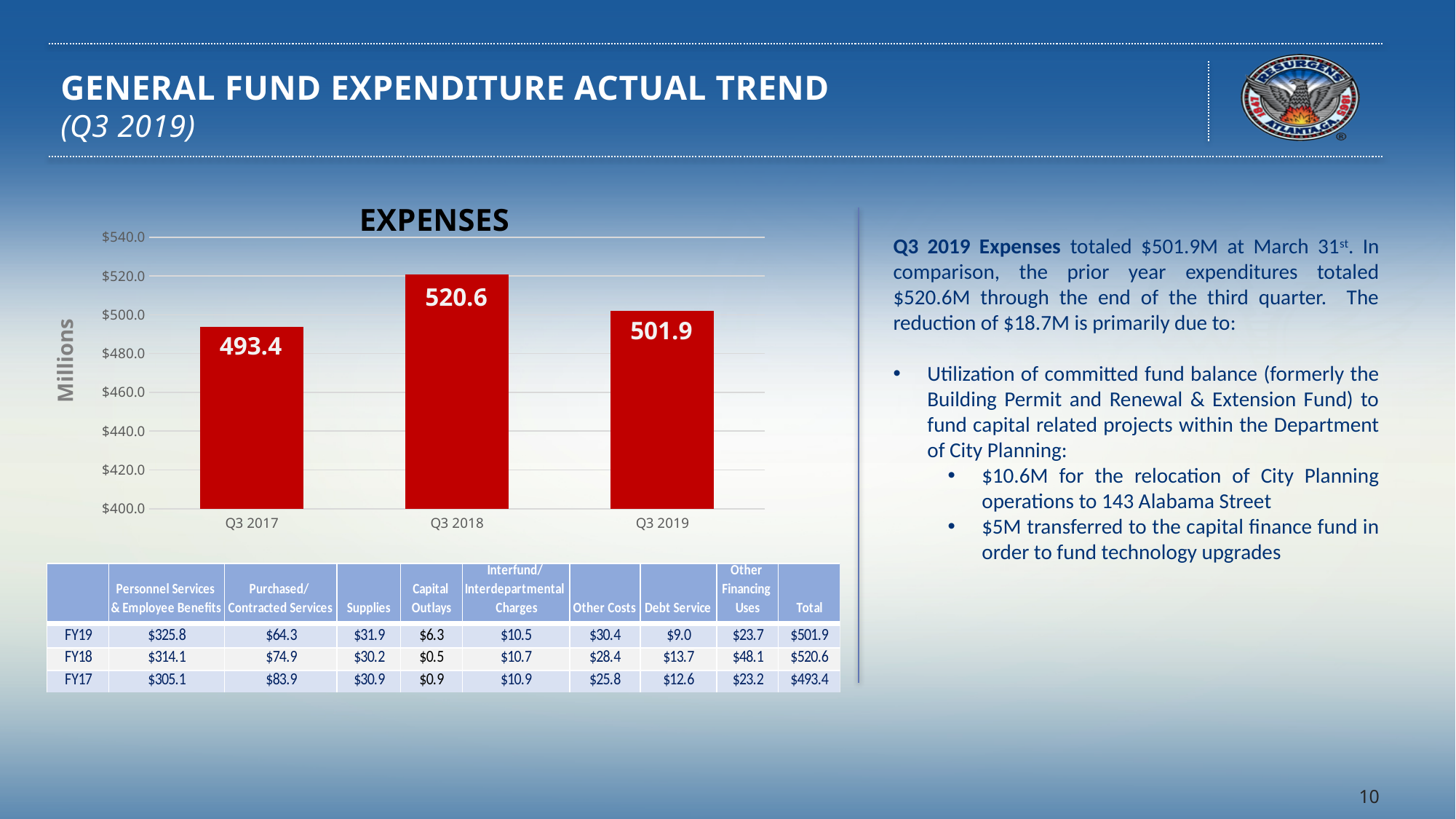
What is the difference between the Q3 2018 and Q3 2019 values in the EXPENSES chart? 18.7 What is the value for Q3 2019 in the EXPENSES chart? 501.9 Which is larger in the EXPENSES chart, Q3 2017 or Q3 2019? Q3 2019 What kind of chart is the EXPENSES chart? bar chart Is the value for Q3 2017 in the EXPENSES chart greater or less than $500.0? less Which quarter has the highest value in the EXPENSES chart? Q3 2018 Which quarter has the lowest value in the EXPENSES chart? Q3 2017 What is the label on the vertical axis of the EXPENSES chart? Millions What is the value for Q3 2017 in the EXPENSES chart? 493.4 What is the value for Q3 2018 in the EXPENSES chart? 520.6 What is the difference between the Q3 2018 and Q3 2017 values in the EXPENSES chart? 27.2 How many bars are shown in the EXPENSES chart? 3